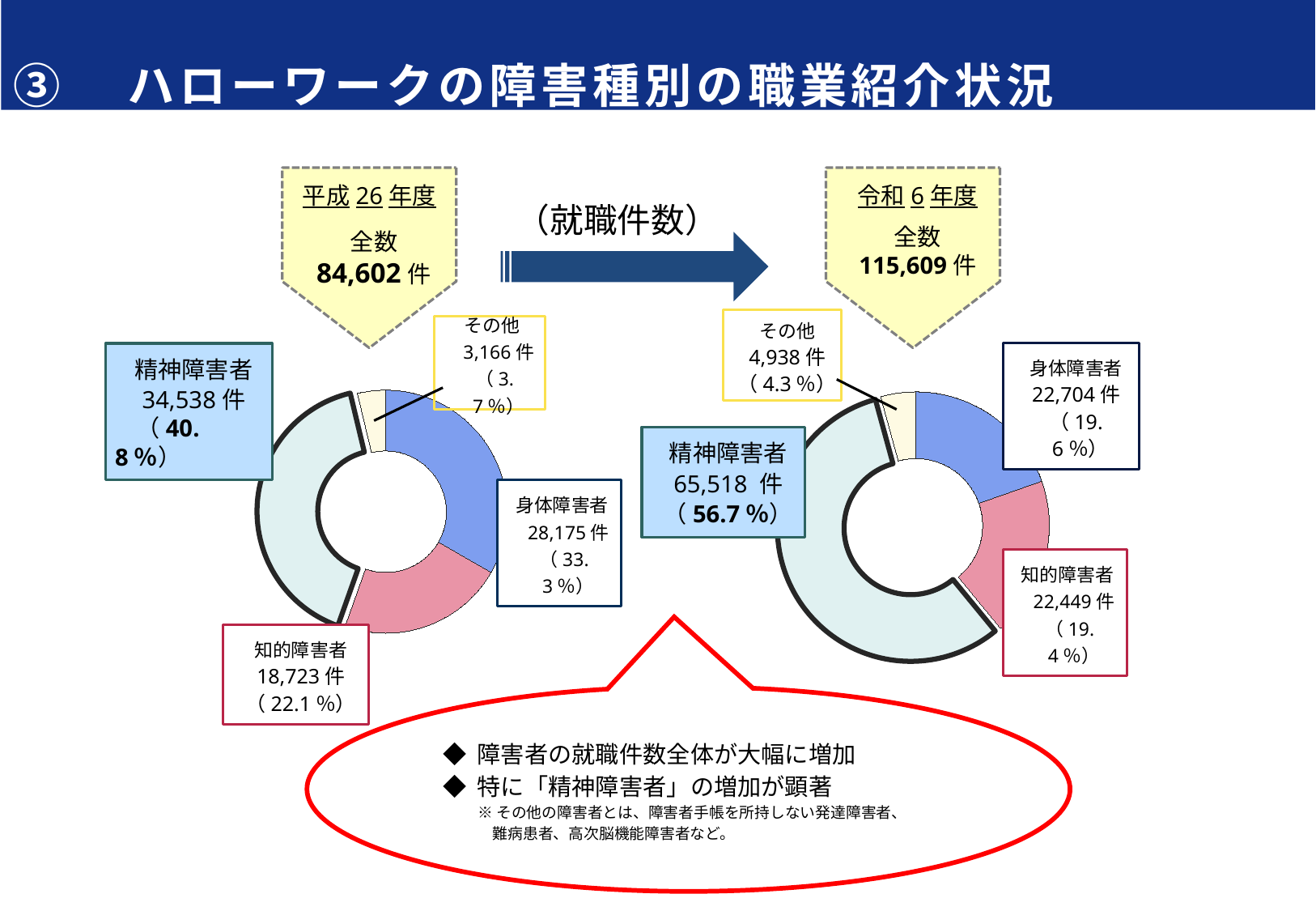
令和6年度のドーナツグラフで、精神障害者の割合は何％ですか？ 56.7 % 平成26年度のドーナツグラフで、精神障害者の就職件数はいくつですか？ 34,538 件 平成26年度のドーナツグラフで、身体障害者と知的障害者ではどちらの就職件数が多いですか？ 身体障害者 平成26年度のドーナツグラフで、就職件数が最も多い障害種別はどれですか？ 精神障害者 令和6年度のドーナツグラフで、身体障害者の就職件数はいくつですか？ 22,704 件 平成26年度のドーナツグラフには、いくつの障害種別（区分）が示されていますか？ 4 平成26年度のドーナツグラフで、知的障害者の割合は何％ですか？ 22.1 % このスライドのグラフはどの種類のグラフですか？ ドーナツグラフ（円グラフ） 令和6年度のドーナツグラフで、その他の割合は何％ですか？ 4.3 % 令和6年度のドーナツグラフで、就職件数が最も少ない障害種別はどれですか？ その他 令和6年度のドーナツグラフで、精神障害者と身体障害者の就職件数の差はいくつですか？ 42,814 件 令和6年度の就職件数の全数はいくつですか？ 115,609 件